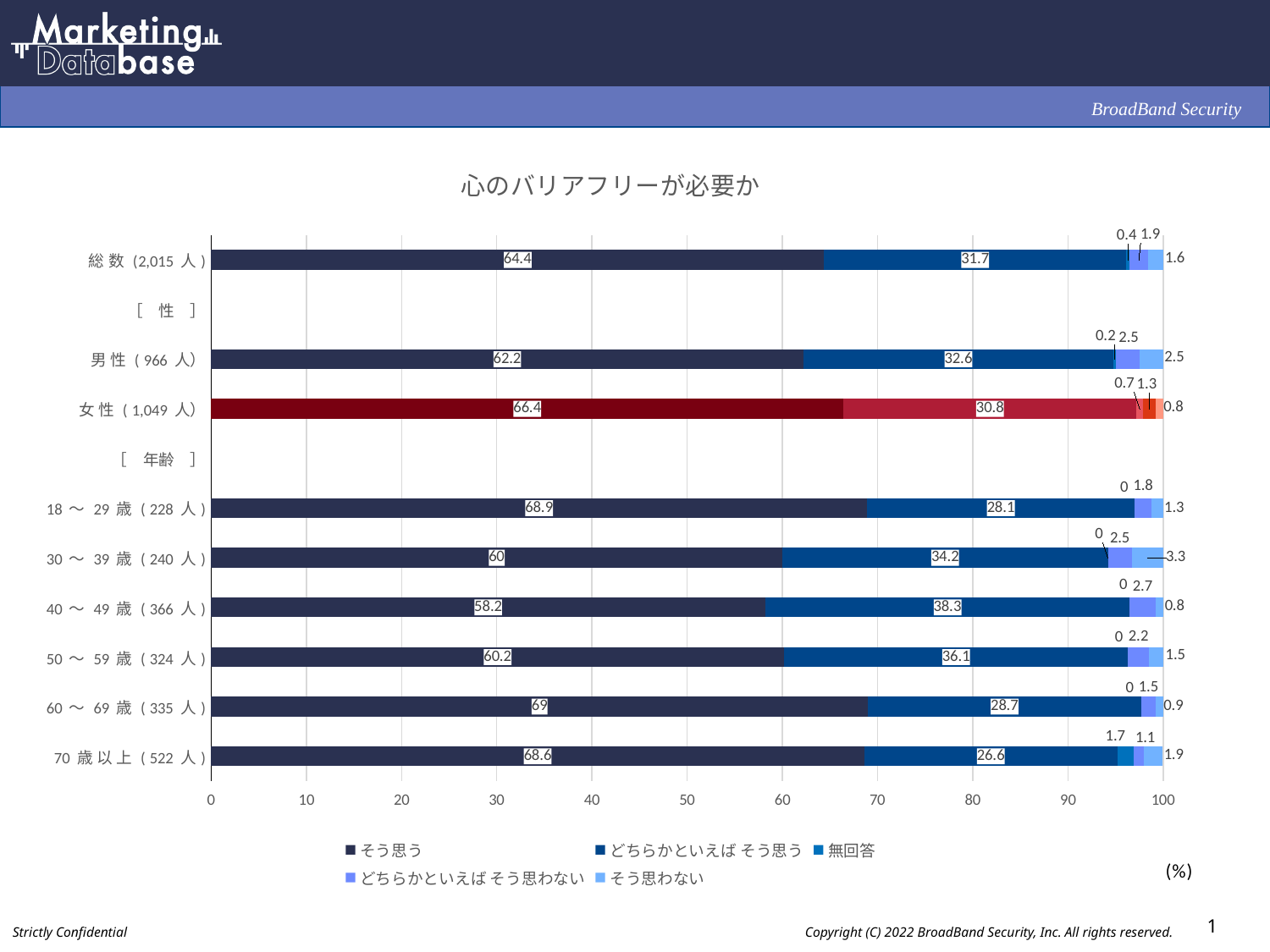
What is the value of そう思う for 70歳以上 (522人)? 68.6 What is the title of the chart? 心のバリアフリーが必要か What is the value of そう思う for 総数 (2,015人)? 64.4 What is the value of どちらかといえば そう思う for 40〜49歳 (366人)? 38.3 Which has the larger value for そう思う, 男性 (966人) or 女性 (1,049人)? 女性 (1,049人) What kind of chart is shown on the slide? bar chart Which category has the lowest value for そう思う? 40〜49歳 (366人) Is the value of そう思う for 30〜39歳 (240人) greater or less than 70? less How many series does the legend list? 5 What is the difference between the そう思う values for 女性 (1,049人) and 男性 (966人)? 4.2 How many categories have bars plotted in the chart? 9 Which category has the highest value for どちらかといえば そう思う? 40〜49歳 (366人)